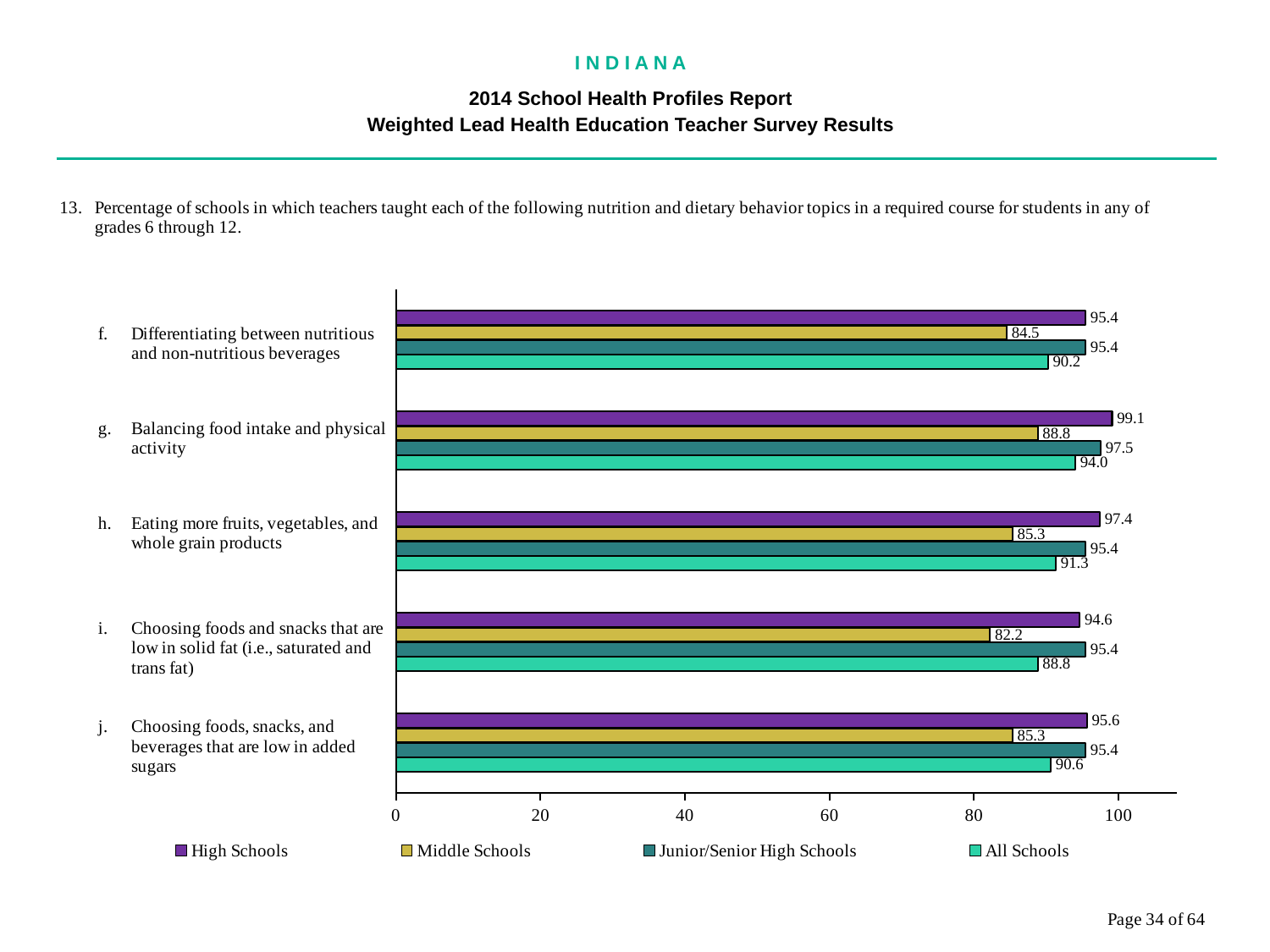
How many nutrition and dietary behavior topics are shown on the chart? 5 Which topic has the lowest Middle Schools value? Choosing foods and snacks that are low in solid fat (i.e., saturated and trans fat) How many series does the legend list? 4 Which topic has the highest High Schools value? Balancing food intake and physical activity What kind of chart is shown on the slide? Bar chart What is the value for Middle Schools for 'Choosing foods and snacks that are low in solid fat (i.e., saturated and trans fat)'? 82.2 What is the value for High Schools for 'Balancing food intake and physical activity'? 99.1 Which legend entry is shown in purple? High Schools What is the All Schools value for 'Differentiating between nutritious and non-nutritious beverages'? 90.2 What is the difference between the High Schools and Middle Schools values for 'Balancing food intake and physical activity'? 10.3 Is the Middle Schools value for 'Choosing foods, snacks, and beverages that are low in added sugars' greater or less than 80? greater For 'Eating more fruits, vegetables, and whole grain products', which is larger: the High Schools value or the Junior/Senior High Schools value? High Schools